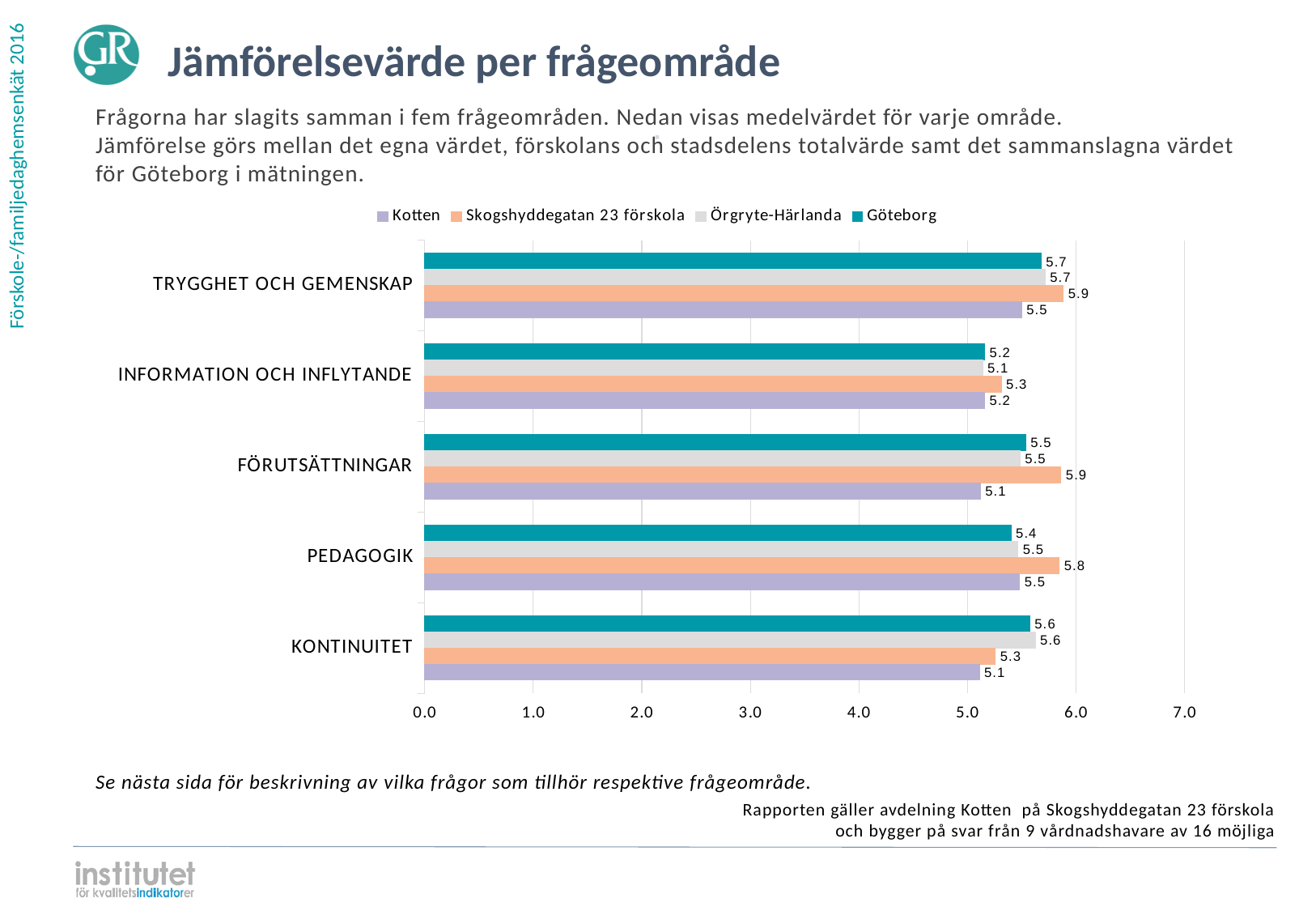
How many categories are shown on the chart? 5 In which category does Kotten have its highest value? TRYGGHET OCH GEMENSKAP and PEDAGOGIK (tied at 5.5) What is the difference between the Skogshyddegatan 23 förskola value and the Kotten value in the FÖRUTSÄTTNINGAR category? 0.8 What is the value for Kotten in the TRYGGHET OCH GEMENSKAP category? 5.5 In the KONTINUITET category, which is larger: the value for Göteborg or the value for Kotten? Göteborg What is the value for Göteborg in the PEDAGOGIK category? 5.4 How many series does the legend list? 4 What is the value for Örgryte-Härlanda in the KONTINUITET category? 5.6 In which category does Skogshyddegatan 23 förskola have its lowest value? INFORMATION OCH INFLYTANDE and KONTINUITET (tied at 5.3) What kind of chart is shown on the slide? Bar chart What is the value for Skogshyddegatan 23 förskola in the FÖRUTSÄTTNINGAR category? 5.9 What is the maximum value shown on the horizontal axis? 7.0